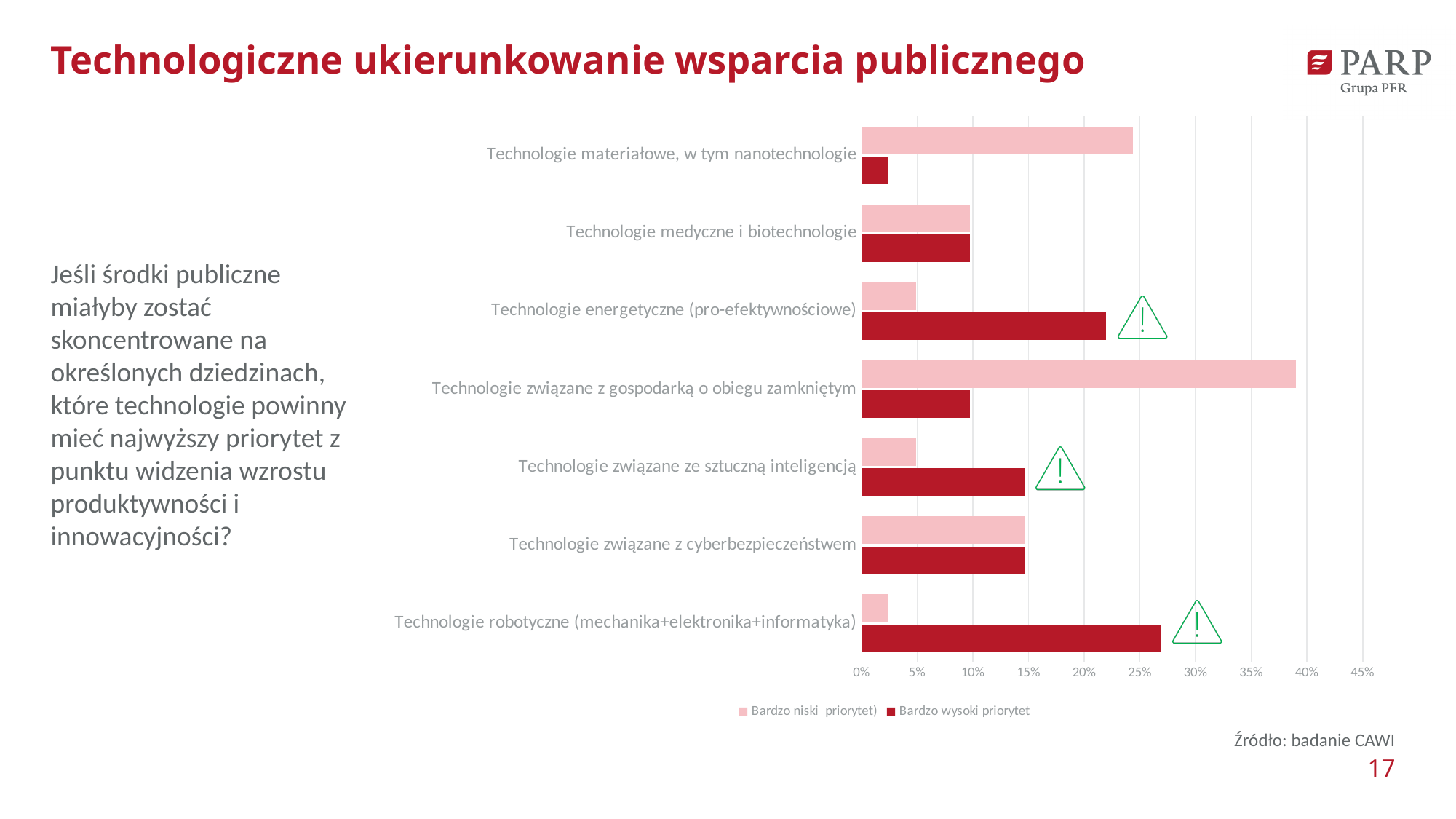
Is the 'Bardzo wysoki priorytet' value for Technologie robotyczne (mechanika+elektronika+informatyka) greater or less than 25%? greater Which category has the highest value for 'Bardzo wysoki priorytet'? Technologie robotyczne (mechanika+elektronika+informatyka) Is the 'Bardzo wysoki priorytet' value for Technologie materiałowe, w tym nanotechnologie greater or less than 5%? less How many technology categories are plotted on the chart? 7 How many series does the chart legend list? 2 What source is cited for the chart data? Źródło: badanie CAWI For Technologie energetyczne (pro-efektywnościowe), which series has the larger value: 'Bardzo niski priorytet' or 'Bardzo wysoki priorytet'? Bardzo wysoki priorytet Which category has the lowest value for 'Bardzo niski priorytet'? Technologie robotyczne (mechanika+elektronika+informatyka) Which category has the highest value for 'Bardzo niski priorytet'? Technologie związane z gospodarką o obiegu zamkniętym Which category has the lowest value for 'Bardzo wysoki priorytet'? Technologie materiałowe, w tym nanotechnologie What kind of chart is shown on the slide? Bar chart Is the 'Bardzo niski priorytet' value for Technologie związane z gospodarką o obiegu zamkniętym greater or less than 35%? greater